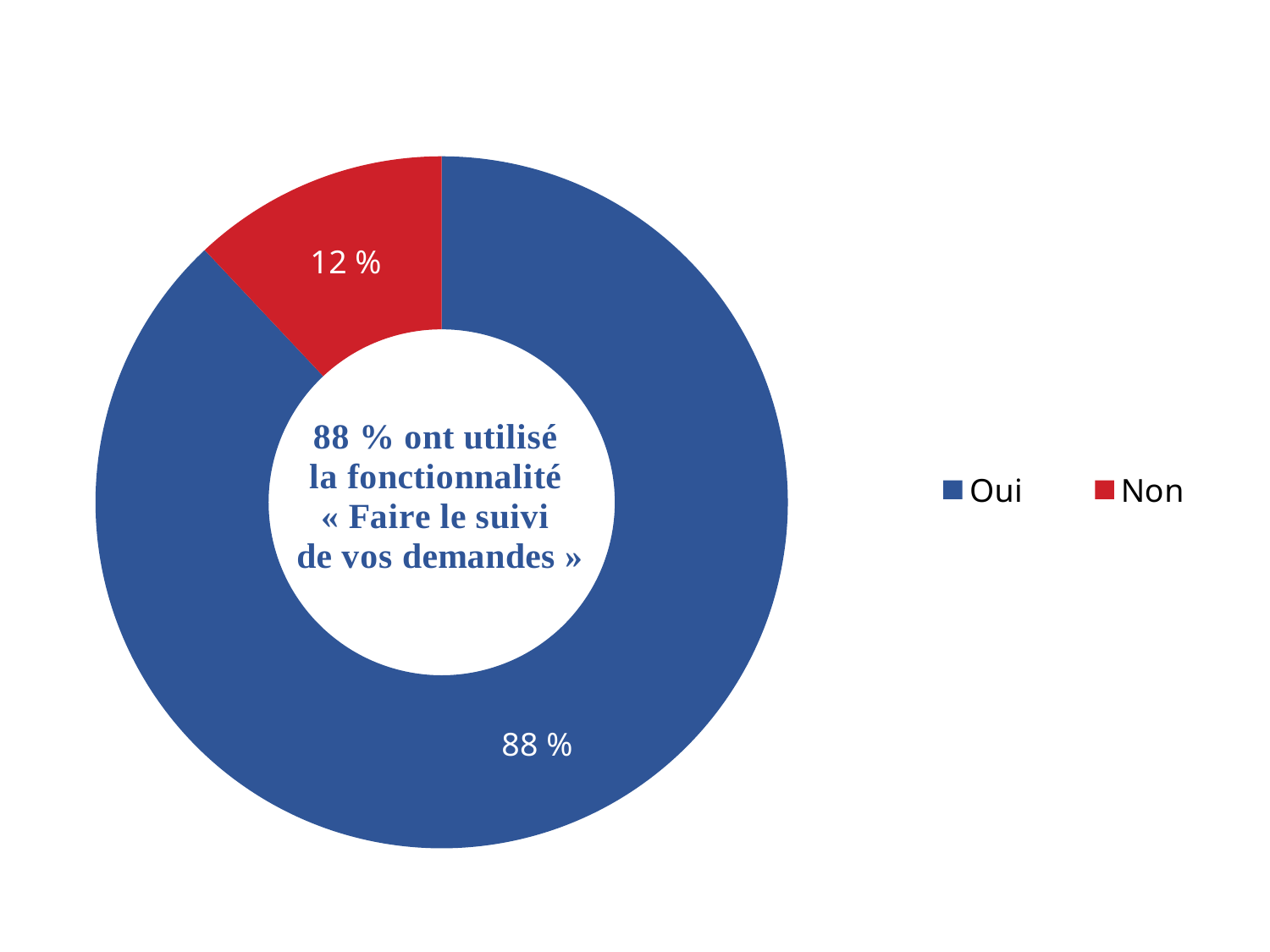
Which category has the largest share of the chart? Oui How many categories does the chart show? 2 What share of the chart does the "Non" slice represent? 12 % What colour is the "Oui" segment of the chart? Blue Which is larger, the share for "Oui" or the share for "Non"? Oui What percentage of the doughnut chart is labelled "Oui"? 88 % What is the difference in percentage points between the "Oui" and "Non" shares? 76 What percentage of the doughnut chart is labelled "Non"? 12 % What text is written in the centre of the doughnut chart? 88 % ont utilisé la fonctionnalité « Faire le suivi de vos demandes » Which category has the smallest share of the chart? Non What kind of chart is shown on the slide? Doughnut chart